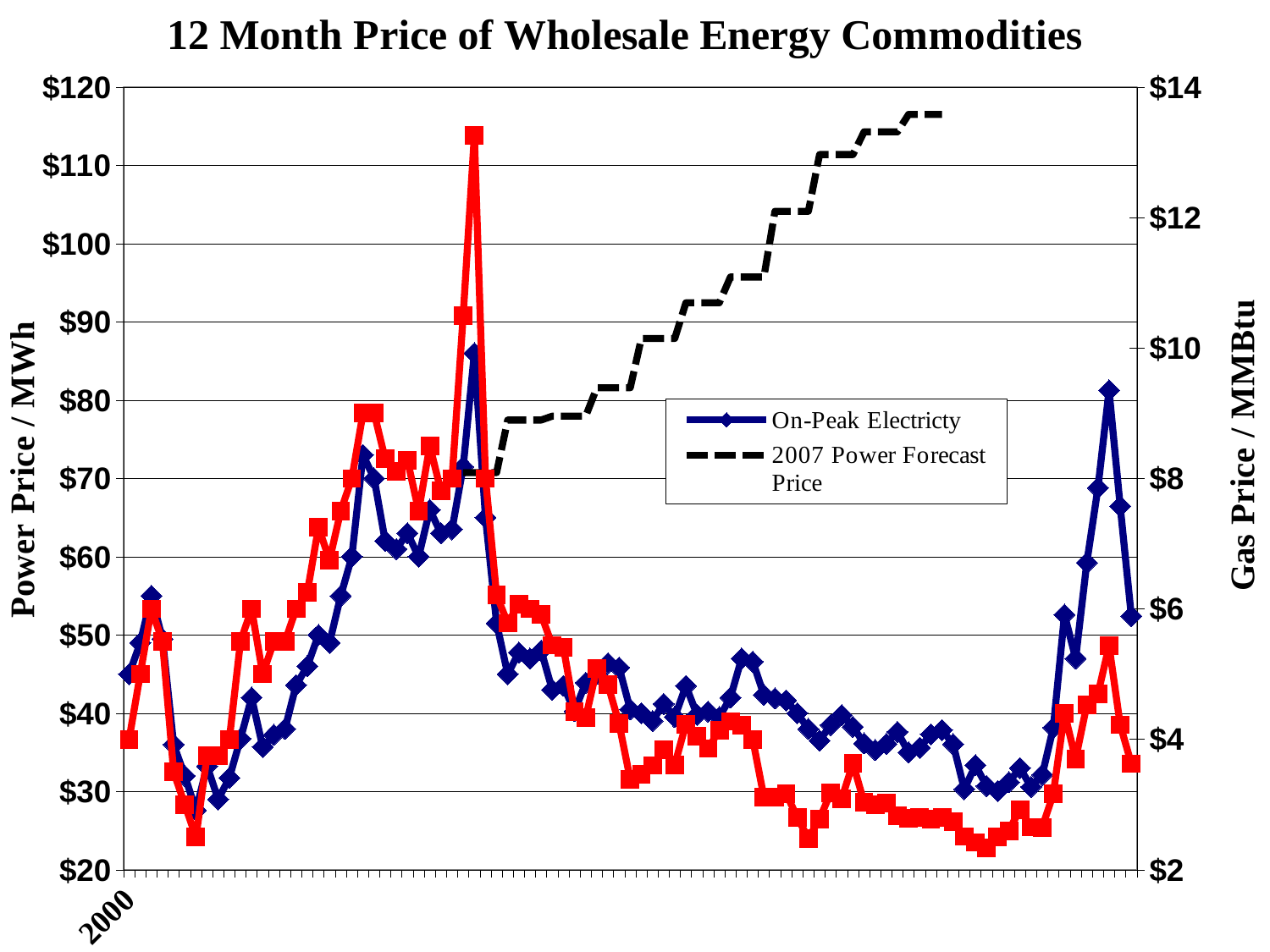
Does the 2007 Power Forecast Price line rise or fall from left to right? rise Is the On-Peak Electricity value at the start of the series (2000) greater or less than $50? less What is the label of the left vertical axis? Power Price / MWh Is the lowest value of the On-Peak Electricity series greater or less than $30? less What is the title of the chart? 12 Month Price of Wholesale Energy Commodities How many series does the chart's legend list? 2 Is the first value of the 2007 Power Forecast Price line greater or less than $80? less What is the maximum value shown on the right vertical axis (Gas Price / MMBtu)? $14 What kind of chart is shown on the slide? line chart